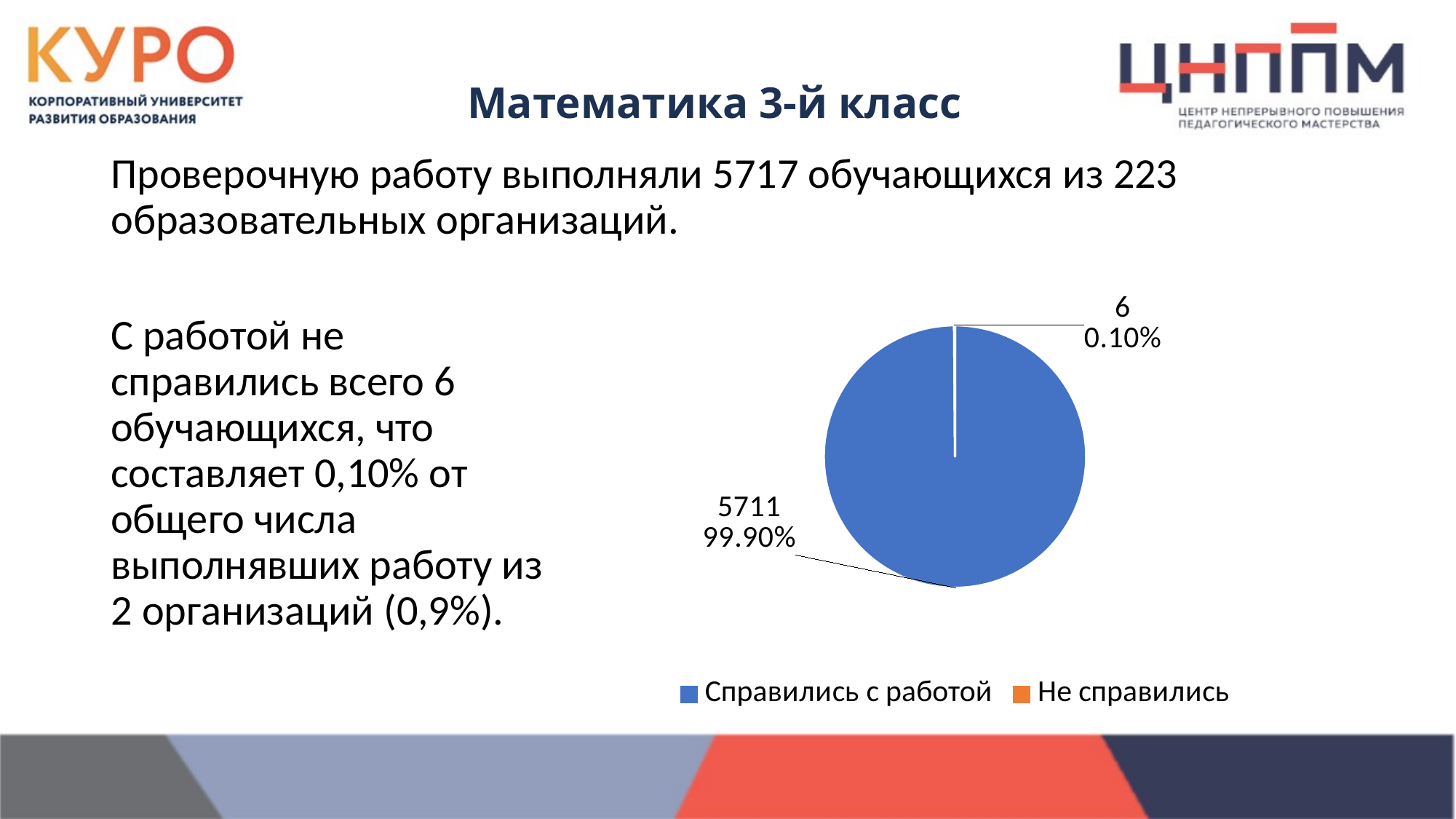
How many students are in the 'Справились с работой' slice of the pie chart? 5711 What kind of chart is shown on the slide? pie chart How many students are in the 'Не справились' slice of the pie chart? 6 What percentage share does the 'Справились с работой' slice have? 99.90% Which is larger: the 'Справились с работой' slice or the 'Не справились' slice? Справились с работой What colour is the 'Не справились' entry in the legend? orange How many entries does the legend list? 2 Which slice of the pie chart is the smallest? Не справились Which slice of the pie chart is the largest? Справились с работой What percentage share does the 'Не справились' slice have? 0.10% What is the difference between the number of students who completed the work and those who did not? 5705 How many slices does the pie chart have? 2